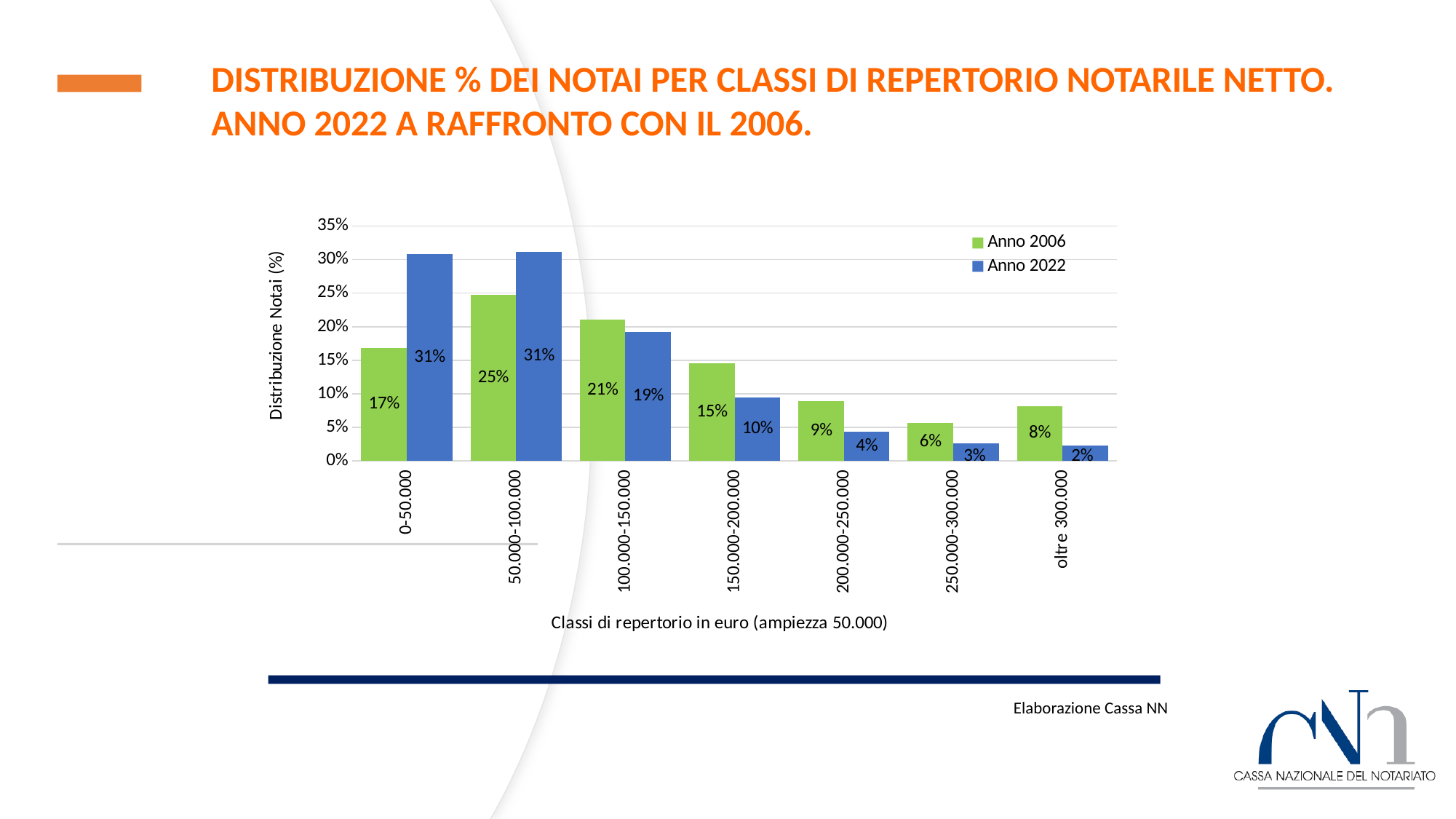
Which class has the lowest value for Anno 2006? 250.000-300.000 In the 100.000-150.000 class, which series has the larger value, Anno 2006 or Anno 2022? Anno 2006 What is the value for Anno 2006 in the 0-50.000 class? 17% How many repertorio classes are shown on the x axis? 7 What is the value for Anno 2022 in the 150.000-200.000 class? 10% How many series does the legend list? 2 Which class has the highest value for Anno 2006? 50.000-100.000 What kind of chart is shown on the slide? Bar chart What is the value for Anno 2022 in the oltre 300.000 class? 2% Which class has the lowest value for Anno 2022? oltre 300.000 What is the difference between the Anno 2022 and Anno 2006 values in the 0-50.000 class? 14 percentage points Do the Anno 2022 values rise or fall from the 50.000-100.000 class to the oltre 300.000 class? Fall